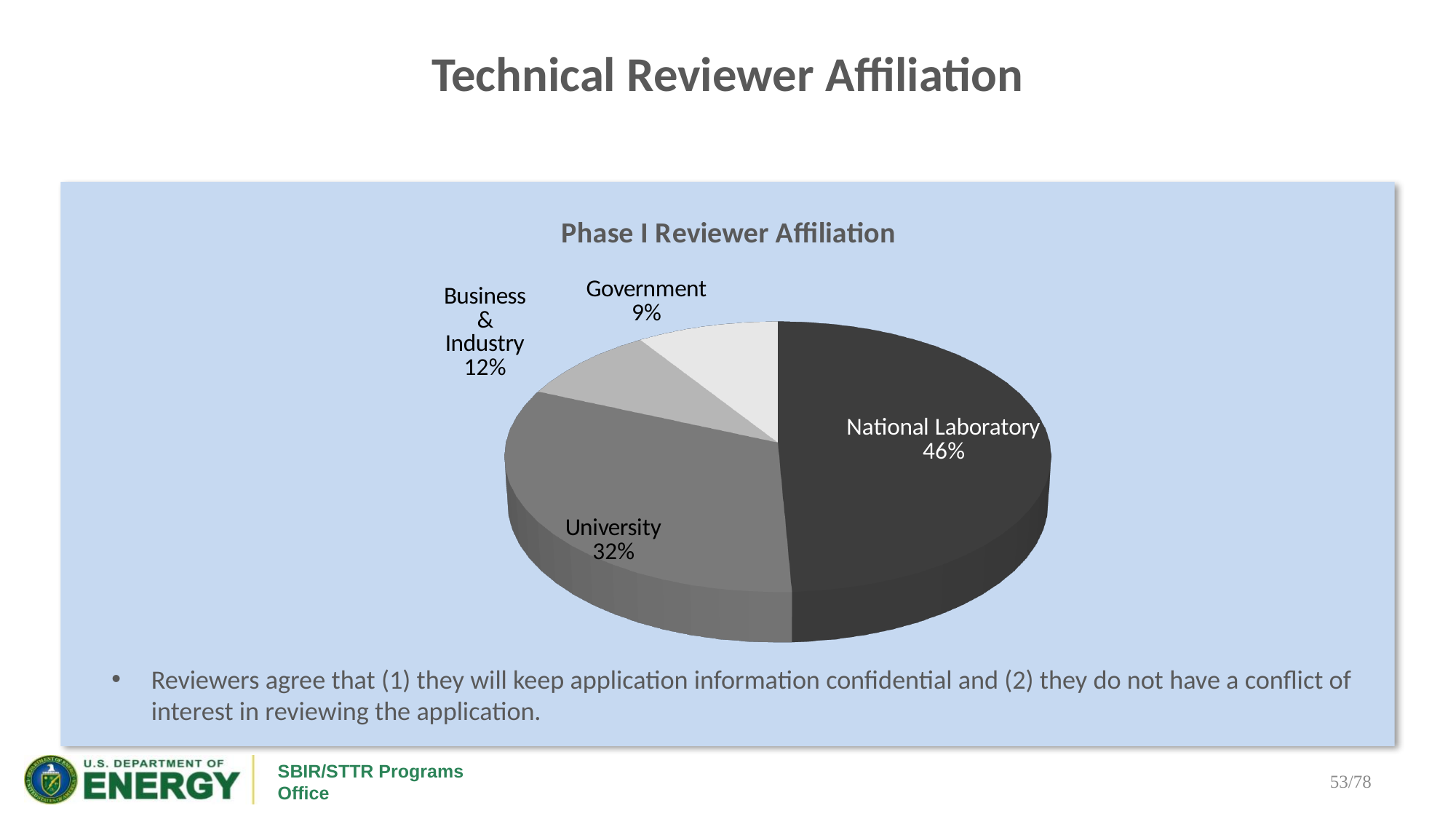
Which has a larger share of Phase I reviewers, University or Business & Industry? University What share of Phase I reviewers are affiliated with Business & Industry? 12% What is the title of the chart? Phase I Reviewer Affiliation What share of Phase I reviewers are affiliated with Government? 9% Which affiliation has the largest share of Phase I reviewers? National Laboratory Which affiliation has the smallest share of Phase I reviewers? Government How many affiliation categories are shown in the pie chart? 4 How many percentage points larger is the National Laboratory share than the University share? 14 What share of Phase I reviewers are affiliated with a National Laboratory? 46% What kind of chart is shown on the slide? Pie chart What share of Phase I reviewers are affiliated with a University? 32% How many percentage points larger is the Business & Industry share than the Government share? 3